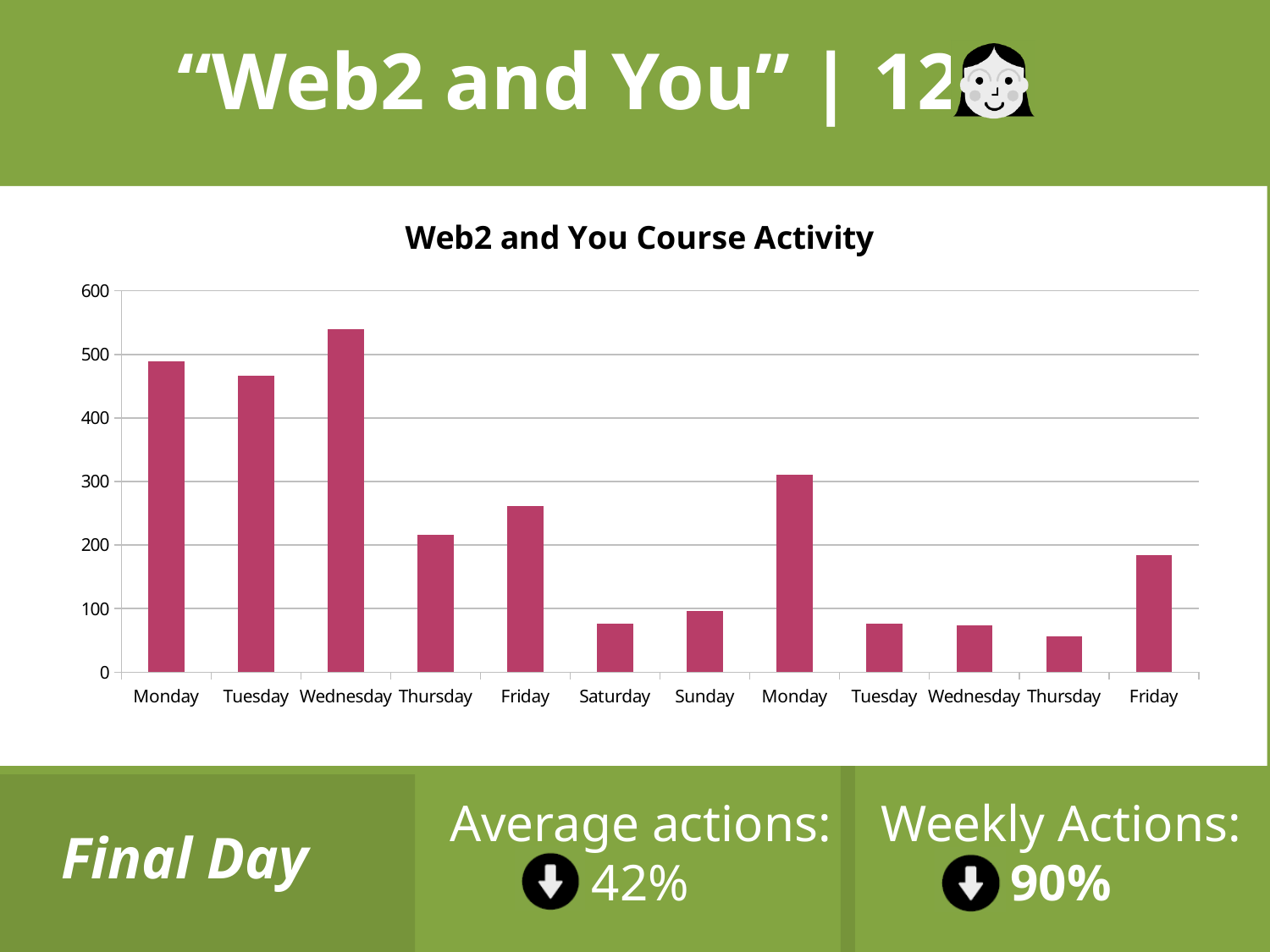
What is the title of the chart? Web2 and You Course Activity Is the value for the second Monday greater or less than 200? greater Which is larger, the value for the second Monday or the second Friday? the second Monday Is the value for the first Thursday greater or less than 300? less Is the value for the first Monday greater or less than 400? greater Which is larger, the value for the first Thursday or the first Friday? the first Friday Which day has the lowest bar in the chart? the second Thursday What kind of chart is shown on the slide? bar chart Which day has the highest bar in the chart? the first Wednesday From the first Wednesday to Saturday, do the values generally rise or fall? fall How many bars are plotted in the chart? 12